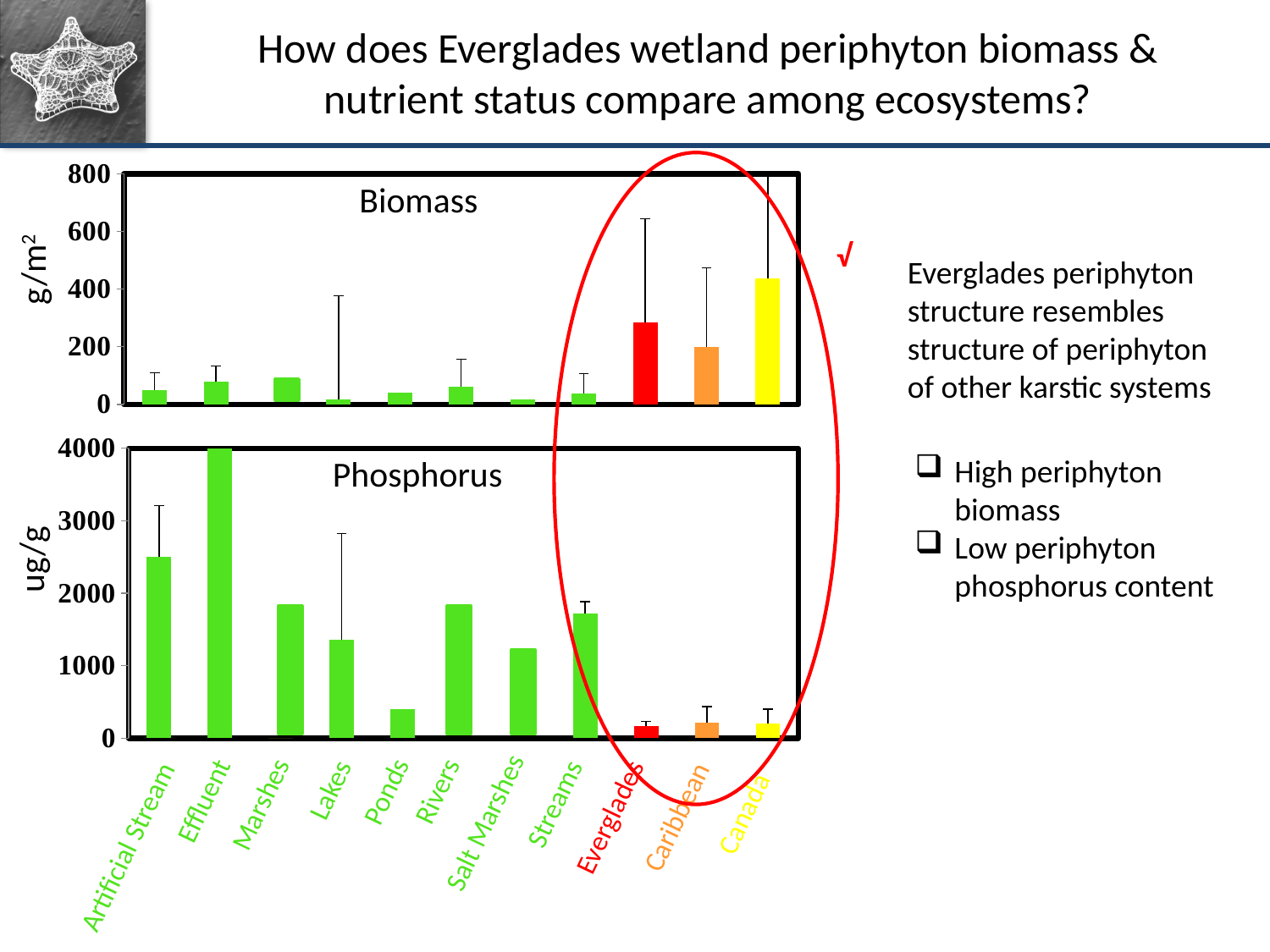
In the Phosphorus chart, which category has the highest value? Effluent In the Biomass chart, is the value for Everglades greater or less than 200? greater In the Phosphorus chart, which is larger, the value for Effluent or the value for Artificial Stream? Effluent In the Biomass chart, which is larger, the value for Everglades or the value for Ponds? Everglades In the Phosphorus chart, is the value for Streams greater or less than 1000? greater What kind of chart is the Biomass chart? bar chart What unit is shown on the y axis of the Phosphorus chart? ug/g In the Biomass chart, which category has the highest value? Canada How many categories are shown on the x axis of the Phosphorus chart? 11 In the Phosphorus chart, is the value for Artificial Stream greater or less than 2000? greater